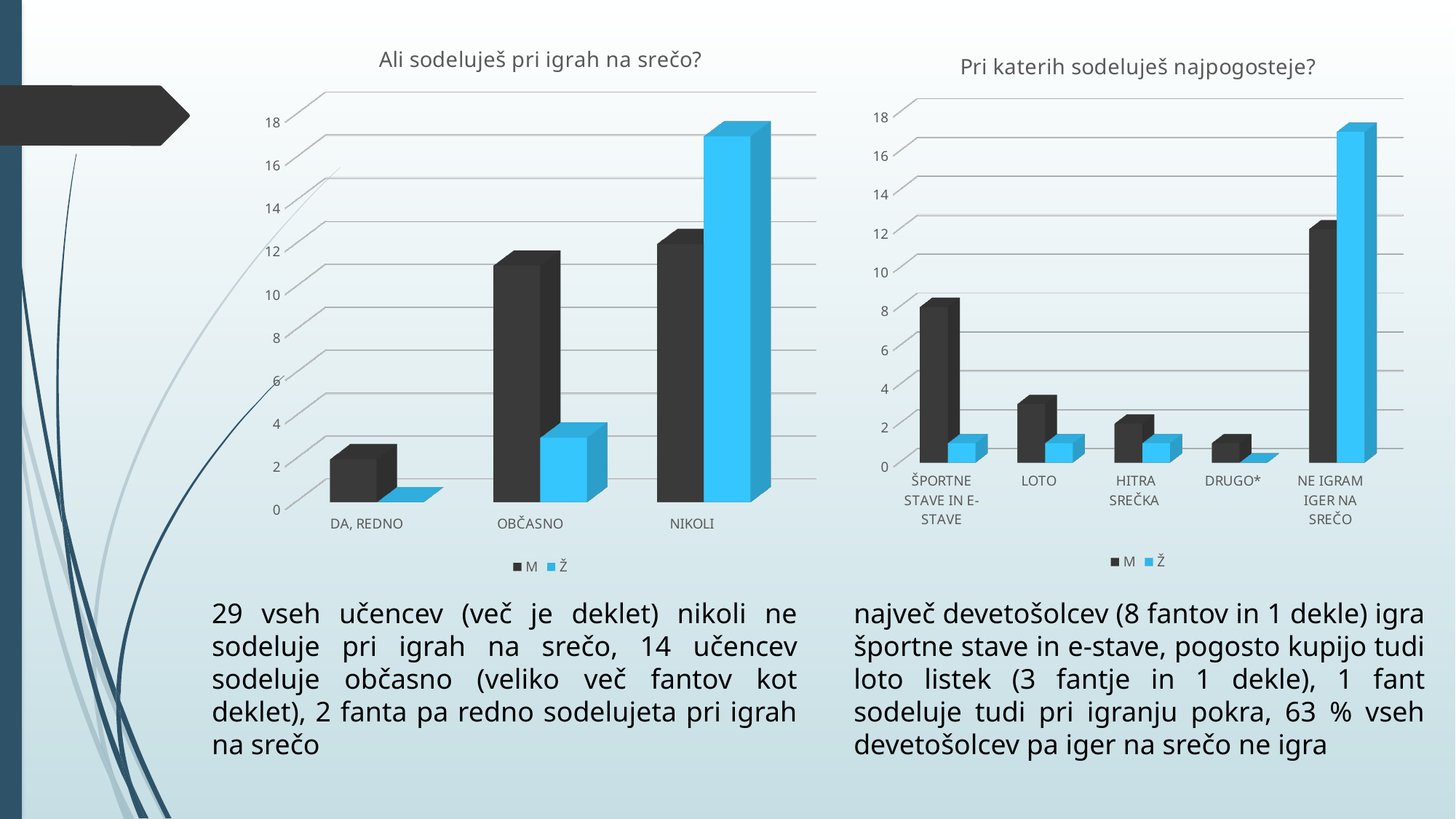
In the chart titled "Ali sodeluješ pri igrah na srečo?", for OBČASNO, which series has the larger value, M or Ž? M How many categories are shown on the x axis of the chart titled "Pri katerih sodeluješ najpogosteje?"? 5 In the chart titled "Pri katerih sodeluješ najpogosteje?", which category has the tallest M bar? NE IGRAM IGER NA SREČO What kind of chart is the chart titled "Ali sodeluješ pri igrah na srečo?"? bar chart In the chart titled "Pri katerih sodeluješ najpogosteje?", is the M value for ŠPORTNE STAVE IN E-STAVE greater or less than 6? greater In the chart titled "Pri katerih sodeluješ najpogosteje?", for NE IGRAM IGER NA SREČO, which series has the larger value, M or Ž? Ž How many series does the legend of the chart titled "Pri katerih sodeluješ najpogosteje?" list? 2 In the chart titled "Ali sodeluješ pri igrah na srečo?", which category has the tallest Ž bar? NIKOLI In the chart titled "Pri katerih sodeluješ najpogosteje?", which category has the lowest M bar? DRUGO* In the chart titled "Ali sodeluješ pri igrah na srečo?", is the M value for DA, REDNO greater or less than 4? less How many categories are shown on the x axis of the chart titled "Ali sodeluješ pri igrah na srečo?"? 3 In the chart titled "Ali sodeluješ pri igrah na srečo?", is the Ž value for NIKOLI greater or less than 14? greater